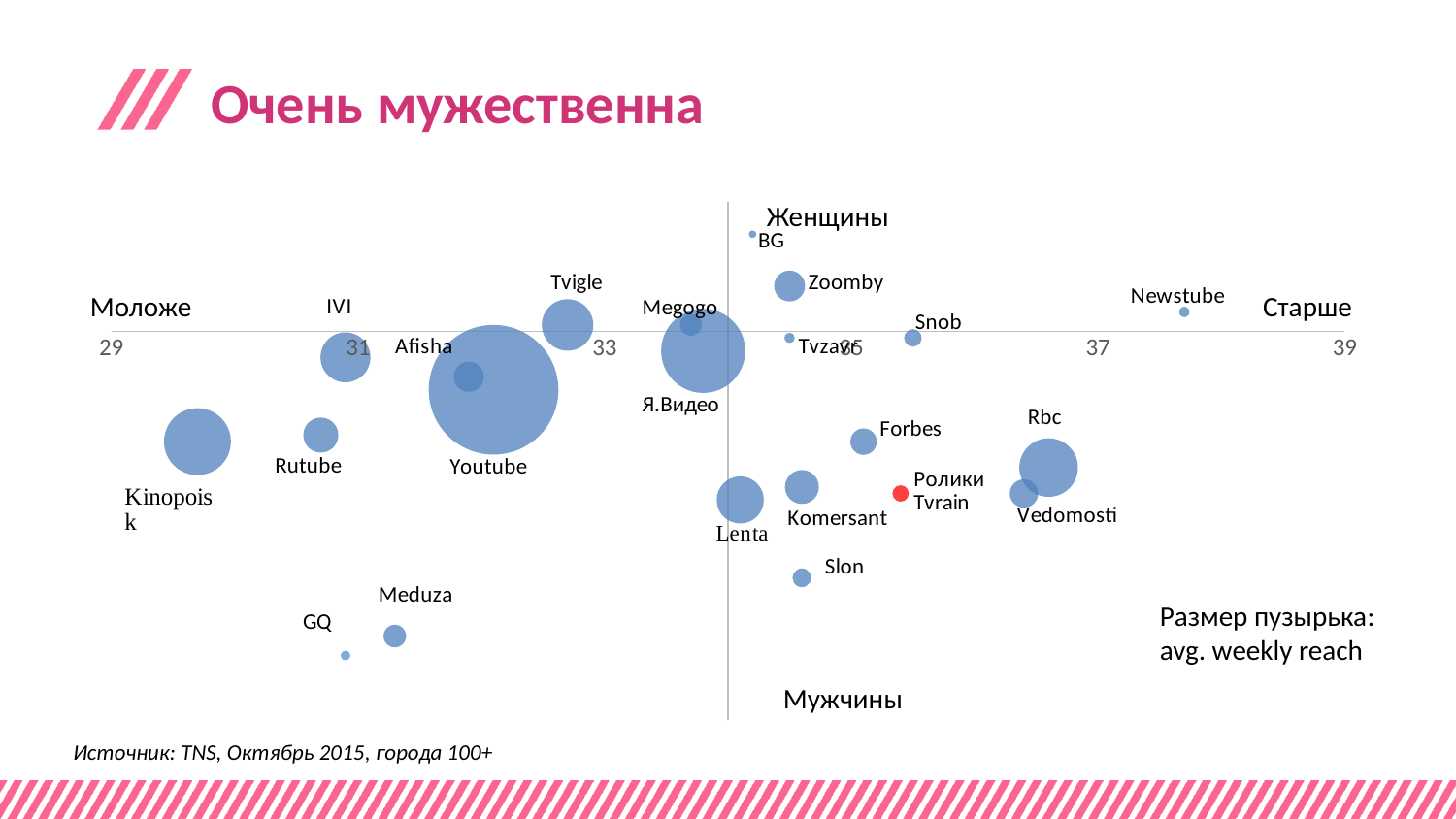
What kind of chart is shown on the slide? Bubble chart Which site has the largest bubble (highest avg. weekly reach)? Youtube Is the horizontal-axis value for Newstube greater or less than 37? greater Which site is plotted lowest on the vertical axis, closest to 'Мужчины'? GQ Which site is plotted furthest to the left (youngest audience)? Kinopoisk Which bubble is larger, Youtube or Rutube? Youtube Is the horizontal-axis value for Kinopoisk greater or less than 31? less According to the legend note, what does the bubble size represent? avg. weekly reach Which site is plotted further to the right on the horizontal axis, Newstube or Kinopoisk? Newstube Is the horizontal-axis value for Rbc greater or less than 35? greater Which site is plotted highest on the vertical axis, closest to 'Женщины'? BG Which site is plotted furthest to the right (oldest audience)? Newstube